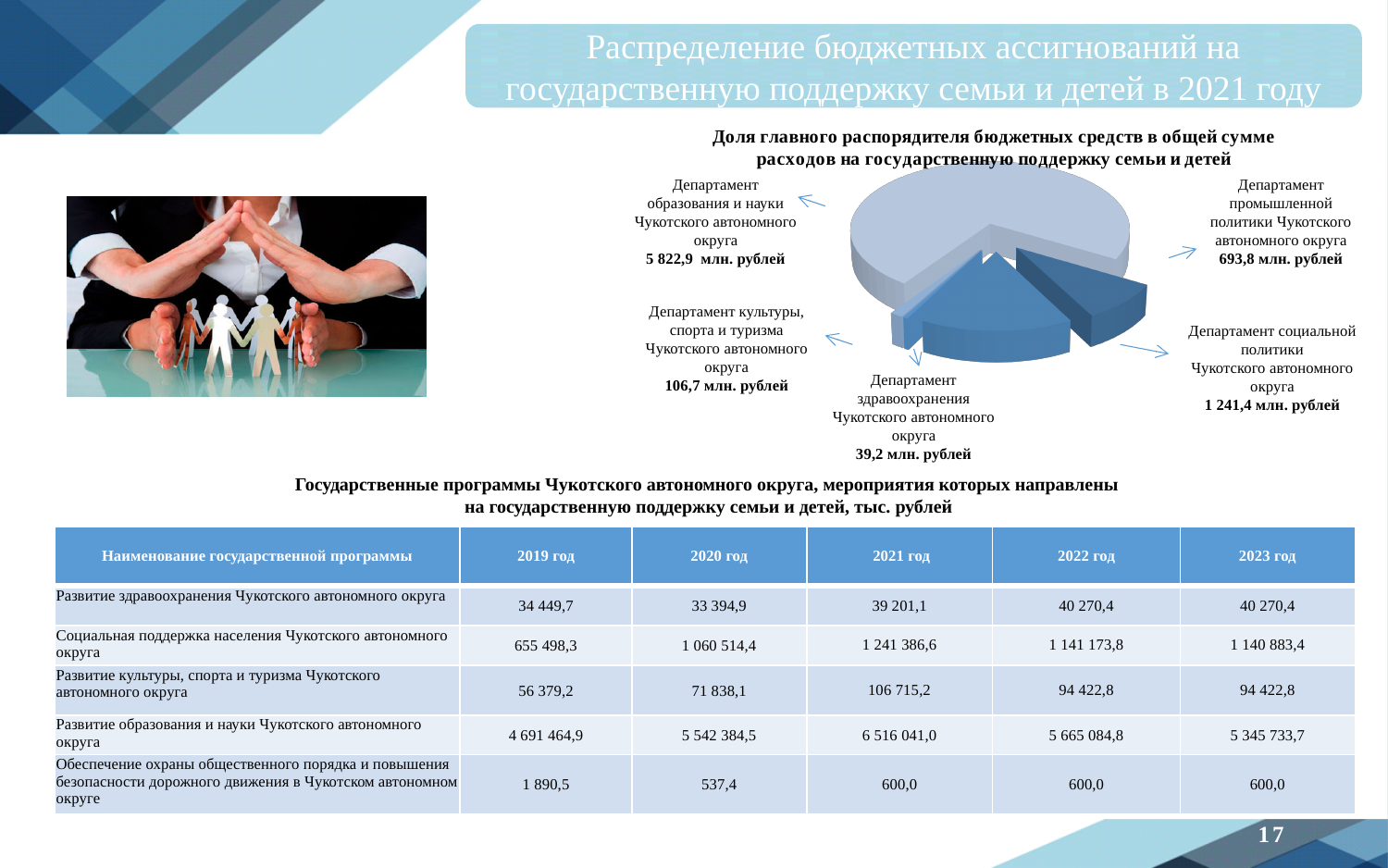
What is the value shown for Департамент образования и науки Чукотского автономного округа in the pie chart? 5 822,9 млн. рублей In the pie chart, what is the difference between the values for Департамент социальной политики and Департамент промышленной политики? 547,6 млн. рублей Which department has the smallest value in the pie chart? Департамент здравоохранения Чукотского автономного округа In the pie chart, what is the difference between the values for Департамент культуры, спорта и туризма and Департамент здравоохранения? 67,5 млн. рублей What is the value shown for Департамент здравоохранения Чукотского автономного округа in the pie chart? 39,2 млн. рублей Which department has the largest value in the pie chart? Департамент образования и науки Чукотского автономного округа What is the title of the pie chart? Доля главного распорядителя бюджетных средств в общей сумме расходов на государственную поддержку семьи и детей What is the value shown for Департамент промышленной политики Чукотского автономного округа in the pie chart? 693,8 млн. рублей What type of chart is shown on the slide? Pie chart How many departments (slices) are shown in the pie chart? 5 In the pie chart, which is larger: the value for Департамент промышленной политики or the value for Департамент культуры, спорта и туризма? Департамент промышленной политики What is the value shown for Департамент социальной политики Чукотского автономного округа in the pie chart? 1 241,4 млн. рублей